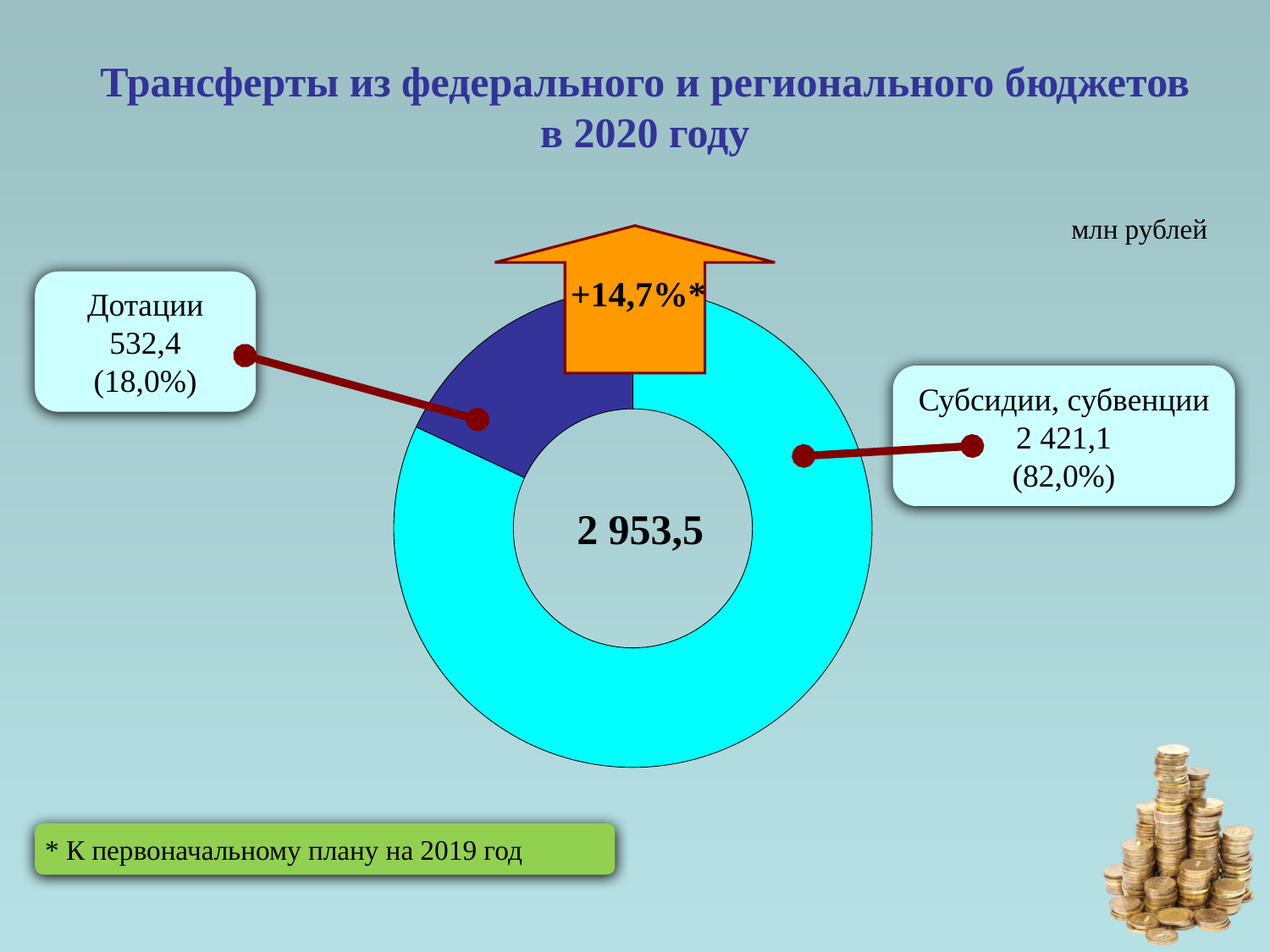
What share of the chart does the Дотации slice represent? 18,0% What is the total value shown in the centre of the chart? 2 953,5 What share of the chart does the Субсидии, субвенции slice represent? 82,0% What is the value for Дотации? 532,4 Which category has the largest slice? Субсидии, субвенции What kind of chart is shown on the slide? Pie (donut) chart What percentage change is shown in the orange arrow above the chart? +14,7% Which is larger, Дотации or Субсидии, субвенции? Субсидии, субвенции Which category has the smallest slice? Дотации How many slices does the chart have? 2 What is the difference between the values for Субсидии, субвенции and Дотации? 1 888,7 What is the value for Субсидии, субвенции? 2 421,1